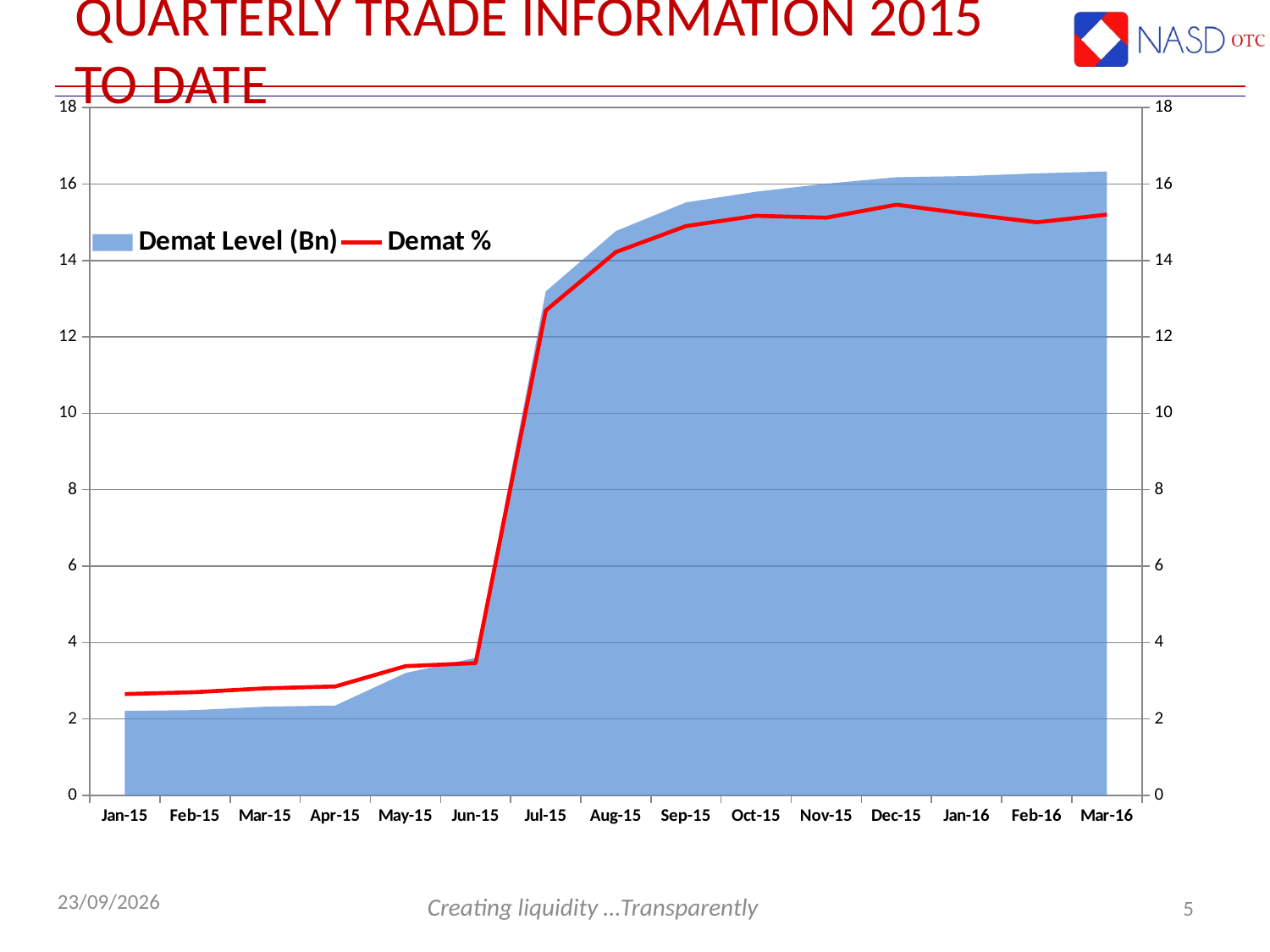
How many series does the chart legend list? 2 In which month is the Demat Level (Bn) highest? Mar-16 Is the Demat % value for Jan-15 greater or less than 4? less Which month has the larger Demat Level (Bn), Jun-15 or Jul-15? Jul-15 How many months are shown on the x axis of the chart? 15 Is the Demat Level (Bn) value for Mar-16 greater or less than 14? greater Does the Demat Level (Bn) series generally rise or fall from Jan-15 to Mar-16? rise Is the Demat Level (Bn) value for Apr-15 greater or less than 4? less What kind of chart is used to plot the Demat Level (Bn) series? area chart What colour is the Demat % line in the chart? red In which month does the Demat % line reach its highest point? Dec-15